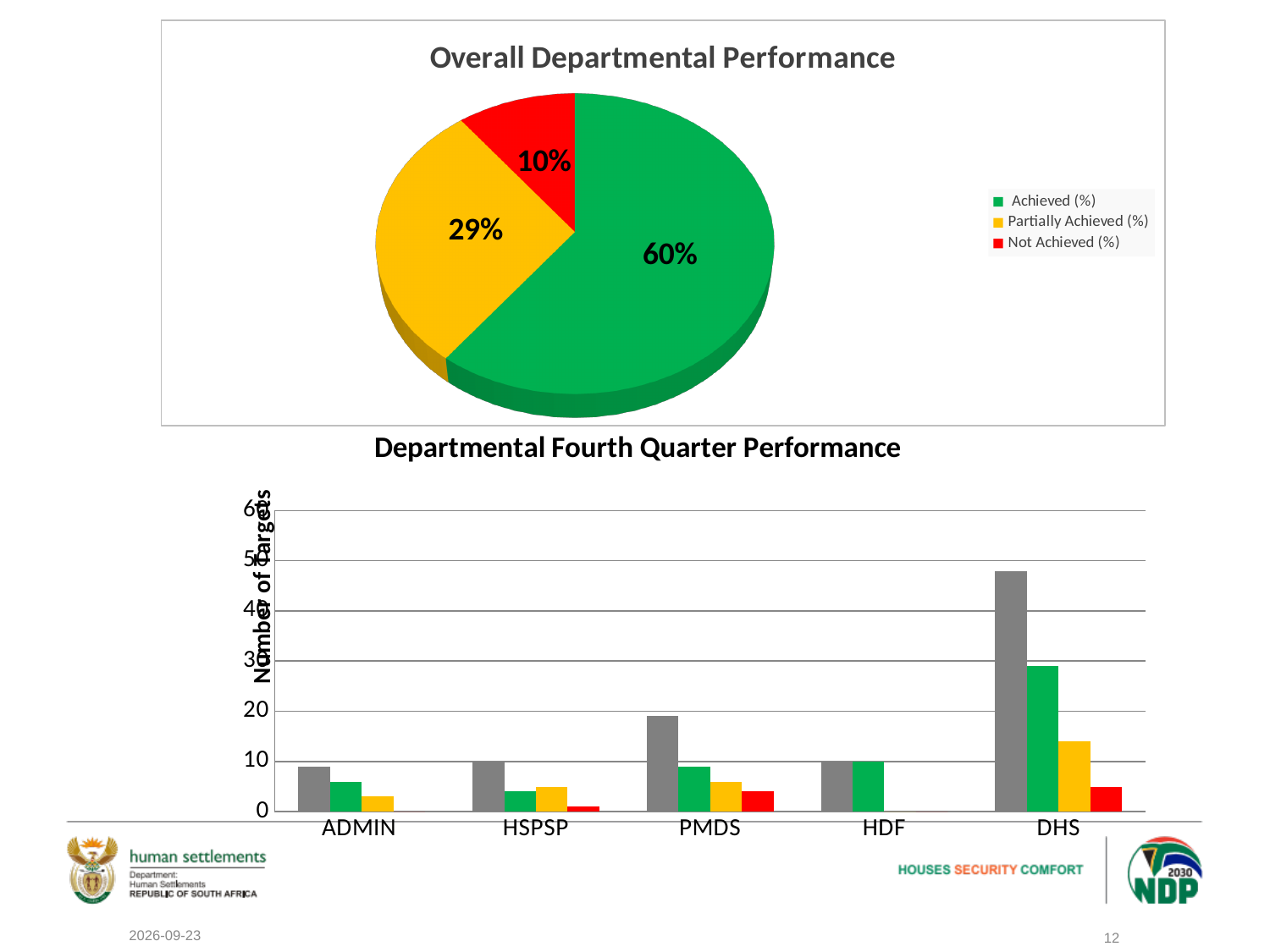
In the Overall Departmental Performance pie chart, what percentage is Not Achieved (%)? 10% In the Departmental Fourth Quarter Performance chart, which category has the tallest bar? DHS What kind of chart is the Departmental Fourth Quarter Performance chart? Bar chart What kind of chart is the Overall Departmental Performance chart? Pie chart In the Overall Departmental Performance pie chart, what percentage is Achieved (%)? 60% How many categories are shown on the x axis of the Departmental Fourth Quarter Performance chart? 5 In the Departmental Fourth Quarter Performance chart, is the value of the tallest grey bar for DHS greater or less than 50? less How many entries does the legend of the Overall Departmental Performance chart list? 3 In the Overall Departmental Performance pie chart, which category has the smallest share? Not Achieved (%) In the Overall Departmental Performance pie chart, what is the difference in percentage points between Achieved (%) and Partially Achieved (%)? 31 In the Overall Departmental Performance pie chart, what percentage is Partially Achieved (%)? 29% In the Overall Departmental Performance pie chart, which category has the largest share? Achieved (%)